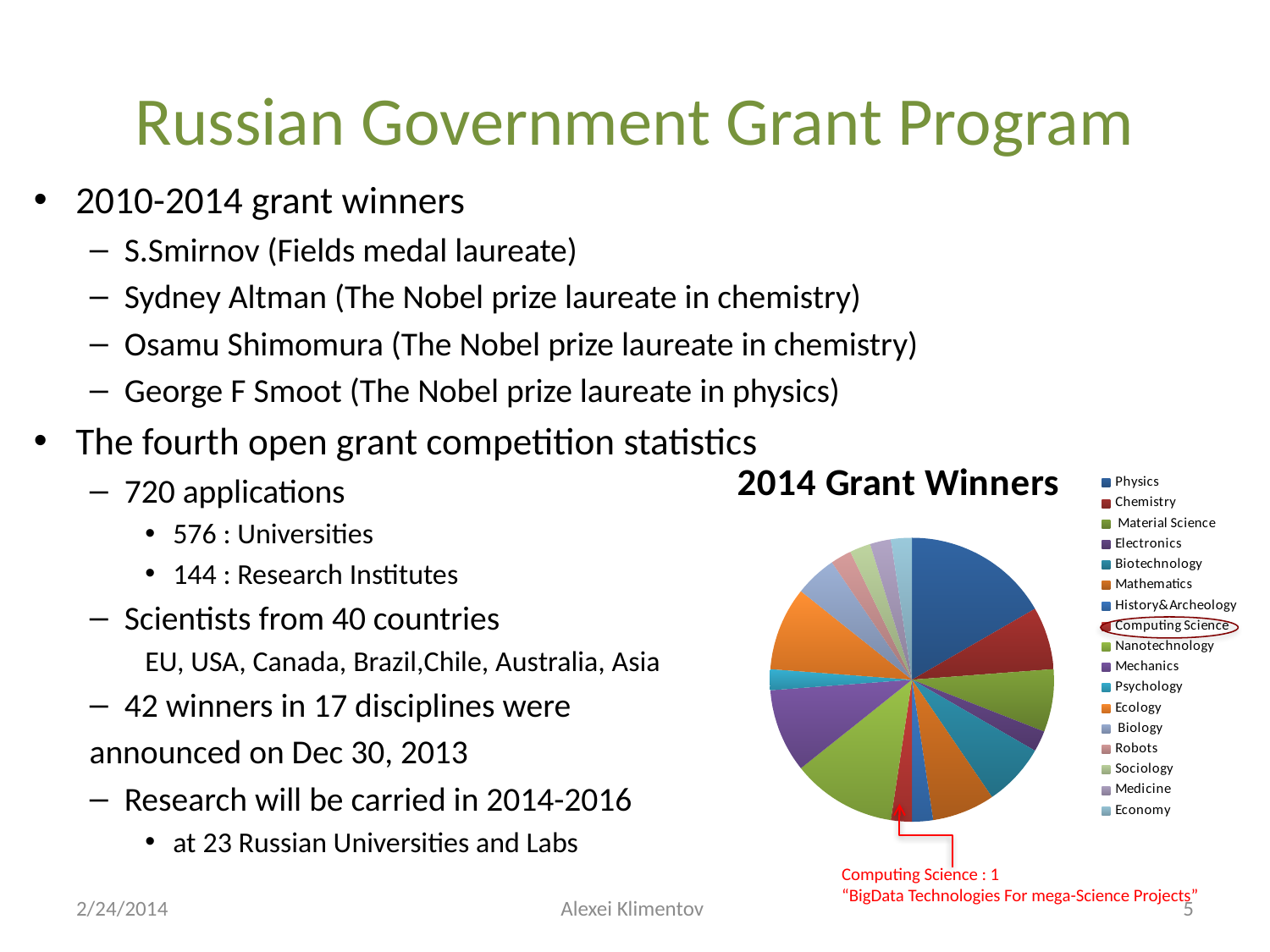
Which category has the largest slice in the pie chart? Physics How many categories does the legend of the pie chart list? 17 Which slice is larger, Material Science or Computing Science? Material Science What is the title of the pie chart? 2014 Grant Winners Which legend entry is circled in red on the pie chart? Computing Science What kind of chart is shown on the slide? pie chart Which slice is larger, Physics or Chemistry? Physics How many grant winners does the annotation give for Computing Science? 1 Which slice is larger, Physics or Computing Science? Physics